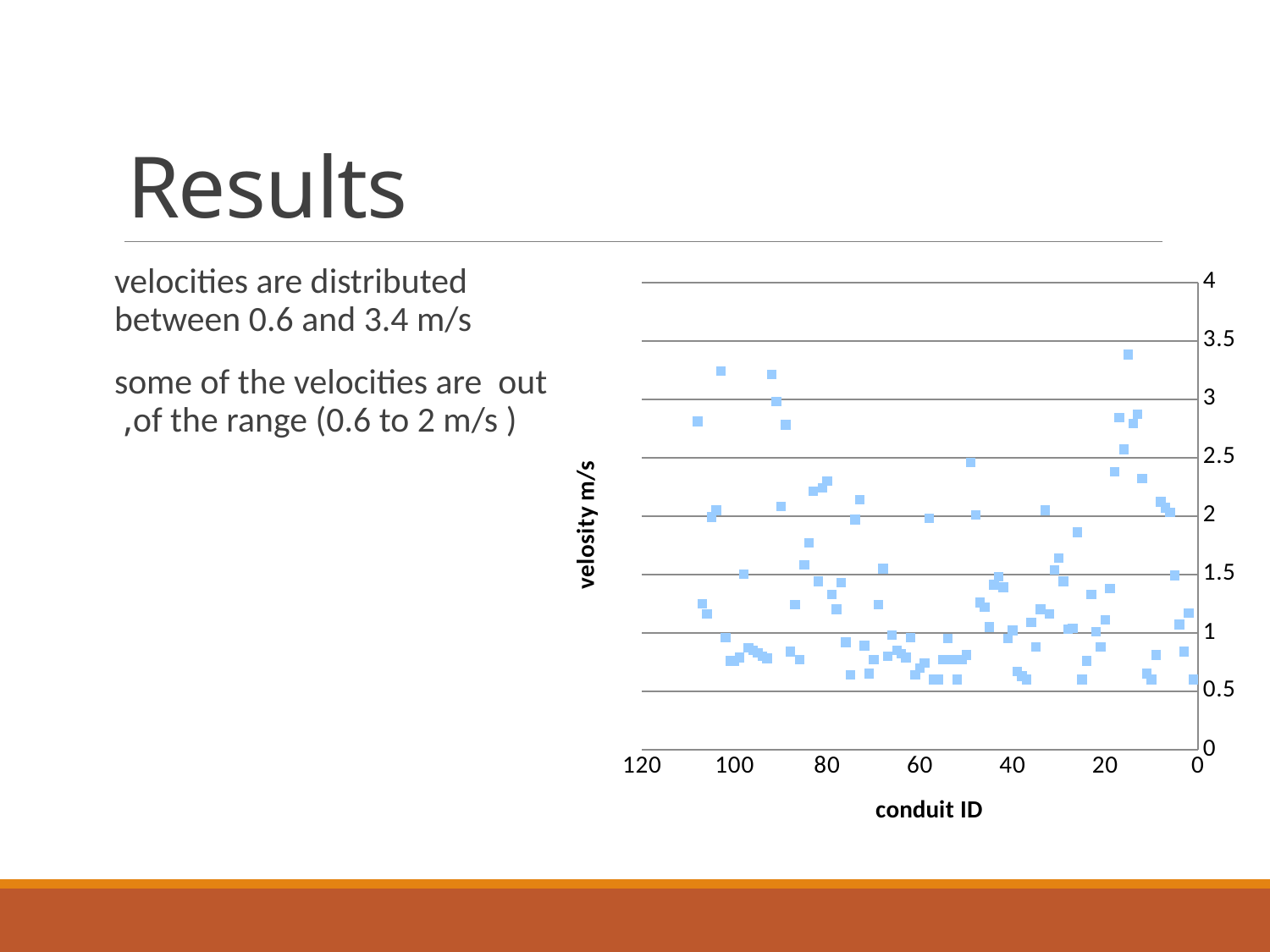
What is the label of the horizontal axis of the chart? conduit ID What kind of chart is shown on the slide? scatter chart What is the label of the vertical axis of the chart? velocity m/s Is the highest velocity plotted on the chart greater or less than 3? greater Is the highest velocity plotted on the chart greater or less than 3.5? less Is the lowest velocity plotted on the chart greater or less than 1? less